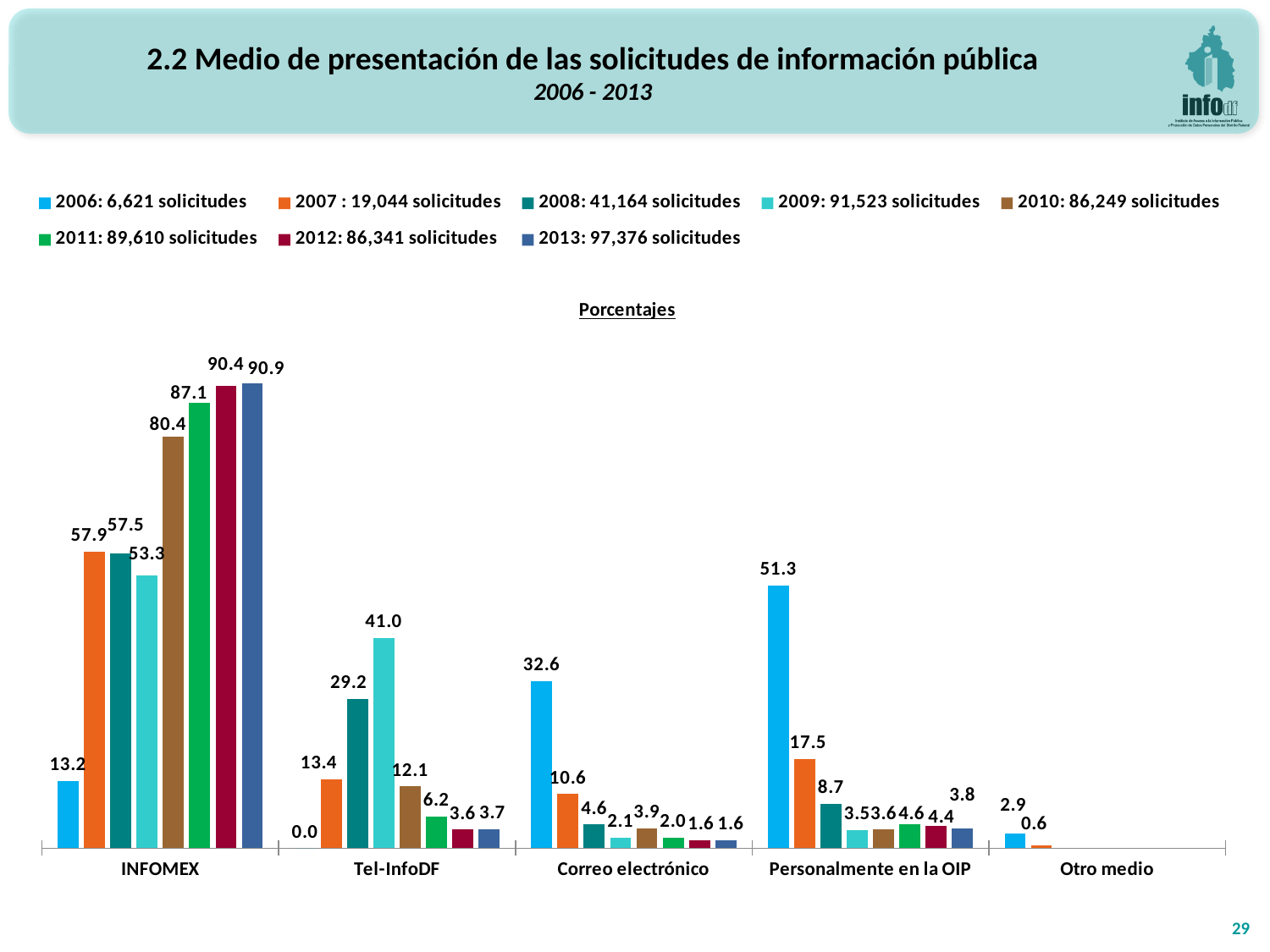
What is the percentage for Tel-InfoDF in 2009? 41.0 What is the percentage for INFOMEX in 2013? 90.9 Does the percentage for INFOMEX rise or fall from 2010 to 2013? rise What is the percentage for Personalmente en la OIP in 2006? 51.3 Which is larger for Personalmente en la OIP: the 2007 value or the 2008 value? 2007 What type of chart is shown on the slide? bar chart According to the legend, how many solicitudes were there in 2013? 97,376 What is the difference between the 2006 and 2007 percentages for Correo electrónico? 22.0 Which year has the lowest percentage for Tel-InfoDF? 2006 How many categories are shown on the x axis? 5 Which year has the highest percentage for INFOMEX? 2013 How many series does the legend list? 8